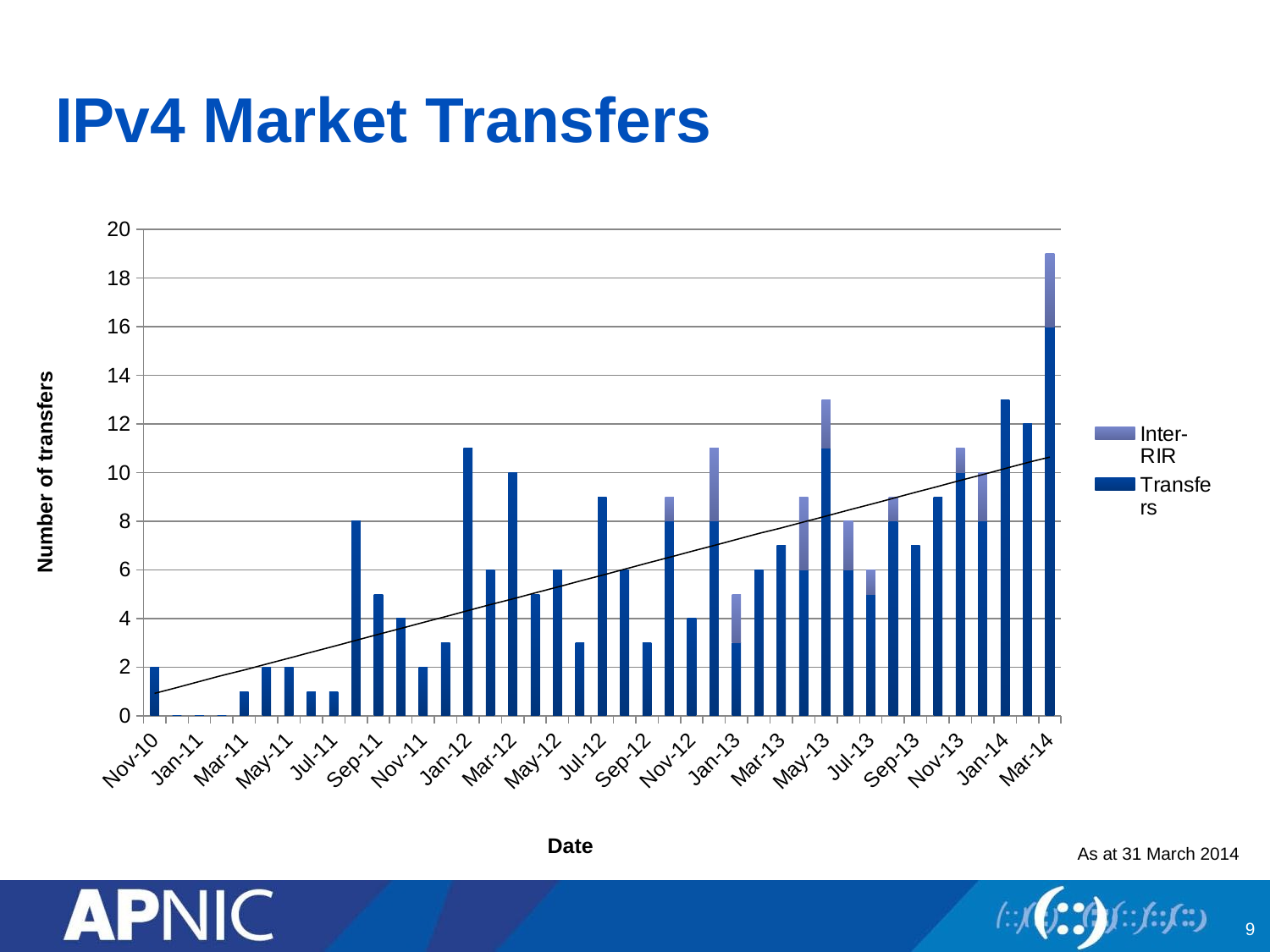
Which month has the highest total number of transfers? Mar-14 Which is larger, the value for Jul-12 or the value for Sep-12? Jul-12 What is the number of transfers for Nov-10? 2 Is the value for Jan-14 greater or less than 12? greater What is the number of transfers for Mar-12? 10 What are the two series named in the legend? Inter-RIR and Transfers Is the total value for Mar-14 greater or less than 18? greater How many series does the legend list? 2 Is the value for Sep-12 greater or less than 4? less What is the title of the y axis? Number of transfers What type of chart is shown on the slide? Bar chart According to the trend line, do the number of transfers generally rise or fall over time? Rise